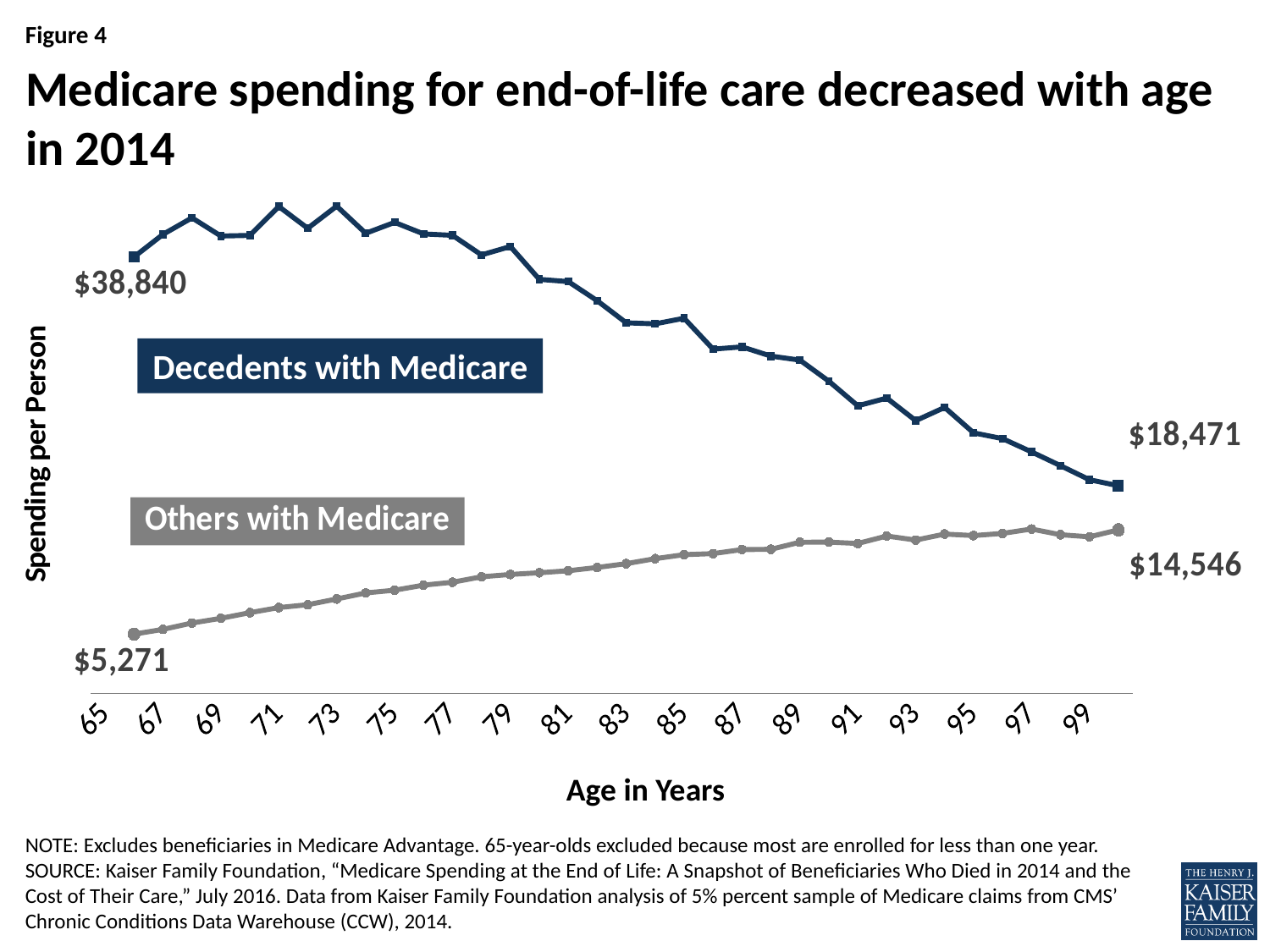
What is the label of the x axis? Age in Years By how much does spending for Decedents with Medicare fall from the leftmost labeled point to the rightmost labeled point? $20,369 What is the spending per person for Others with Medicare at the rightmost point of the line? $14,546 What is the spending per person for Decedents with Medicare at the rightmost point of the line? $18,471 What is the spending per person for Decedents with Medicare at the leftmost point of the line? $38,840 How much higher is the Decedents with Medicare line than the Others with Medicare line at the rightmost point? $3,925 Does spending per person for Others with Medicare generally rise or fall as age increases? Rise What is the spending per person for Others with Medicare at the leftmost point of the line? $5,271 By how much does spending for Others with Medicare rise from the leftmost labeled point to the rightmost labeled point? $9,275 What type of chart is shown on the slide? Line chart Does spending per person for Decedents with Medicare generally rise or fall as age increases? Fall How many series are plotted on the chart? 2